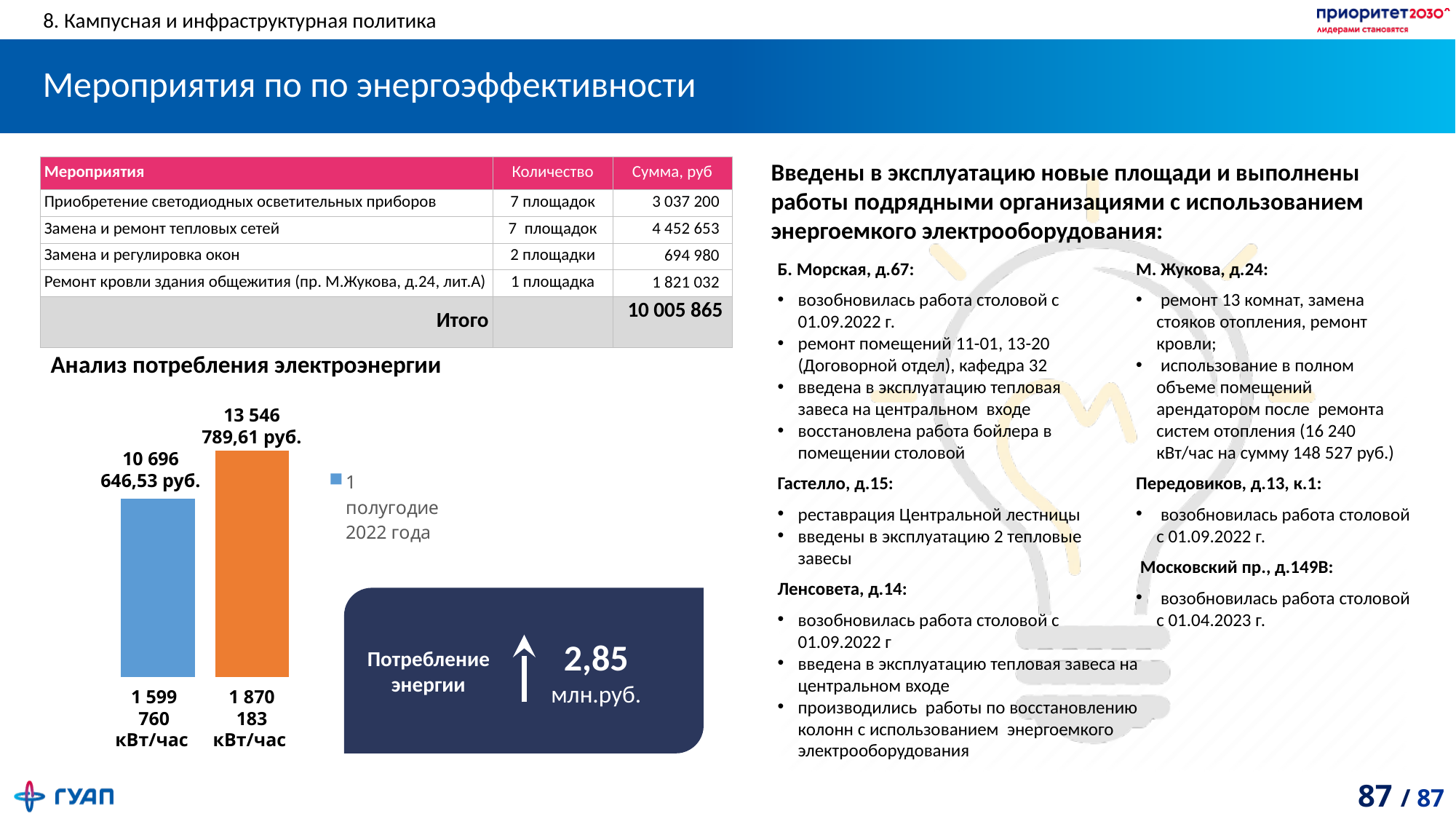
In the chart "Анализ потребления электроэнергии", what is the difference between the values for 1 870 183 кВт/час and 1 599 760 кВт/час? 2 850 143,08 руб. How many bars are plotted in the chart "Анализ потребления электроэнергии"? 2 In the chart "Анализ потребления электроэнергии", which bar is the highest? 1 870 183 кВт/час What kind of chart is shown under the heading "Анализ потребления электроэнергии"? bar chart In the chart "Анализ потребления электроэнергии", what colour is the bar for 1 870 183 кВт/час? orange How many entries does the legend of the chart "Анализ потребления электроэнергии" show? 1 Do the values in the chart "Анализ потребления электроэнергии" rise or fall from left to right? rise In the chart "Анализ потребления электроэнергии", what value is labelled on the bar for 1 599 760 кВт/час? 10 696 646,53 руб. What legend entry is shown next to the chart "Анализ потребления электроэнергии"? 1 полугодие 2022 года In the chart "Анализ потребления электроэнергии", which bar is the lowest? 1 599 760 кВт/час In the chart "Анализ потребления электроэнергии", which is larger: the value for 1 599 760 кВт/час or the value for 1 870 183 кВт/час? 1 870 183 кВт/час In the chart "Анализ потребления электроэнергии", what value is labelled on the bar for 1 870 183 кВт/час? 13 546 789,61 руб.